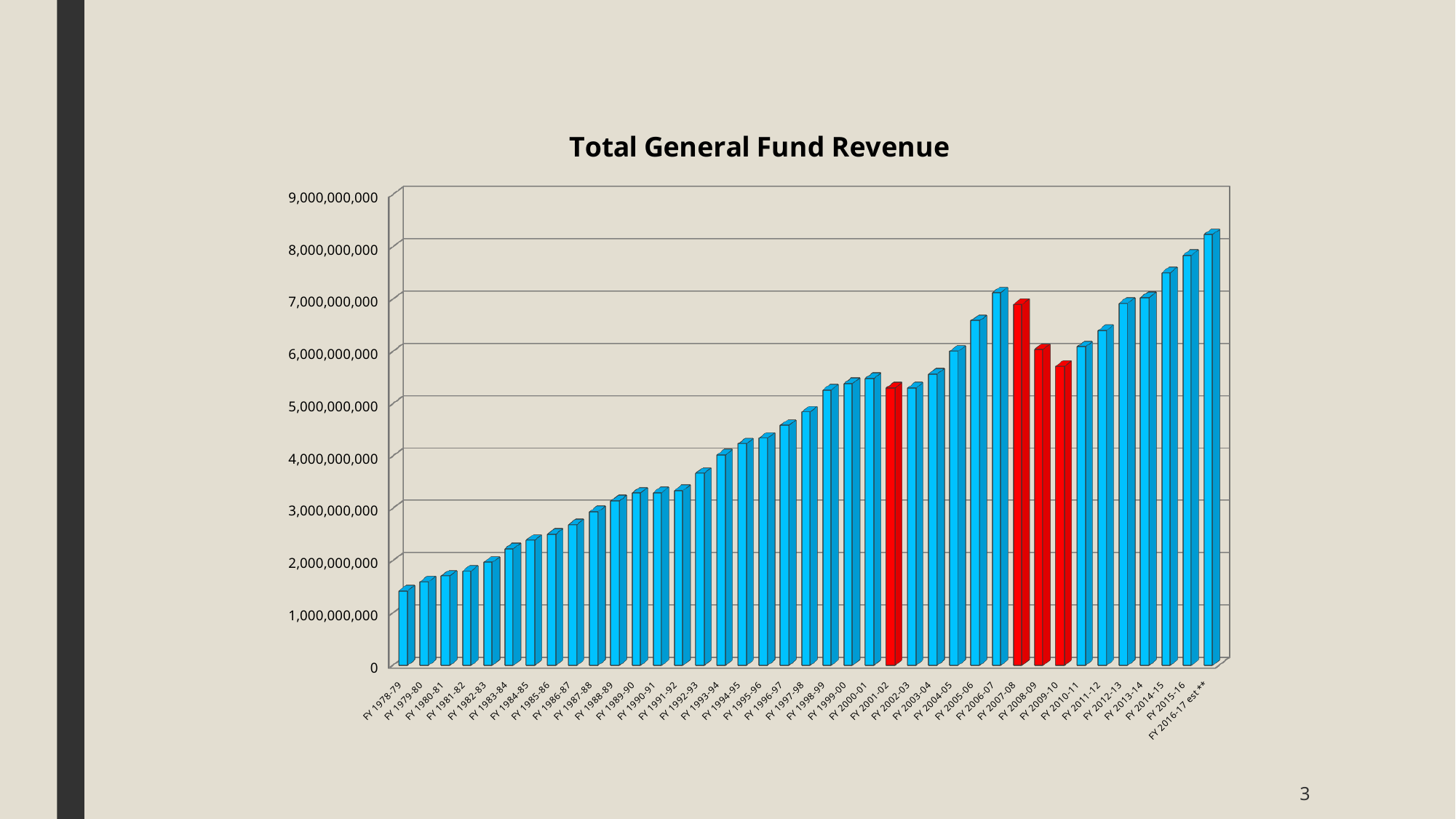
What is the title of the chart? Total General Fund Revenue Which fiscal year has the lowest Total General Fund Revenue? FY 1978-79 How many fiscal years are plotted on the x axis? 39 Is the value for FY 1985-86 greater or less than 2,000,000,000? greater Is the value for FY 2009-10 greater or less than 6,000,000,000? less Which is larger, the value for FY 2007-08 or FY 2008-09? FY 2007-08 Which fiscal year has the highest Total General Fund Revenue? FY 2016-17 est ** How many bars are coloured red rather than blue? 4 Is the value for FY 1978-79 greater or less than 2,000,000,000? less What kind of chart is shown on the slide? Bar chart Do the values generally rise or fall from FY 1978-79 to FY 2016-17 est **? rise